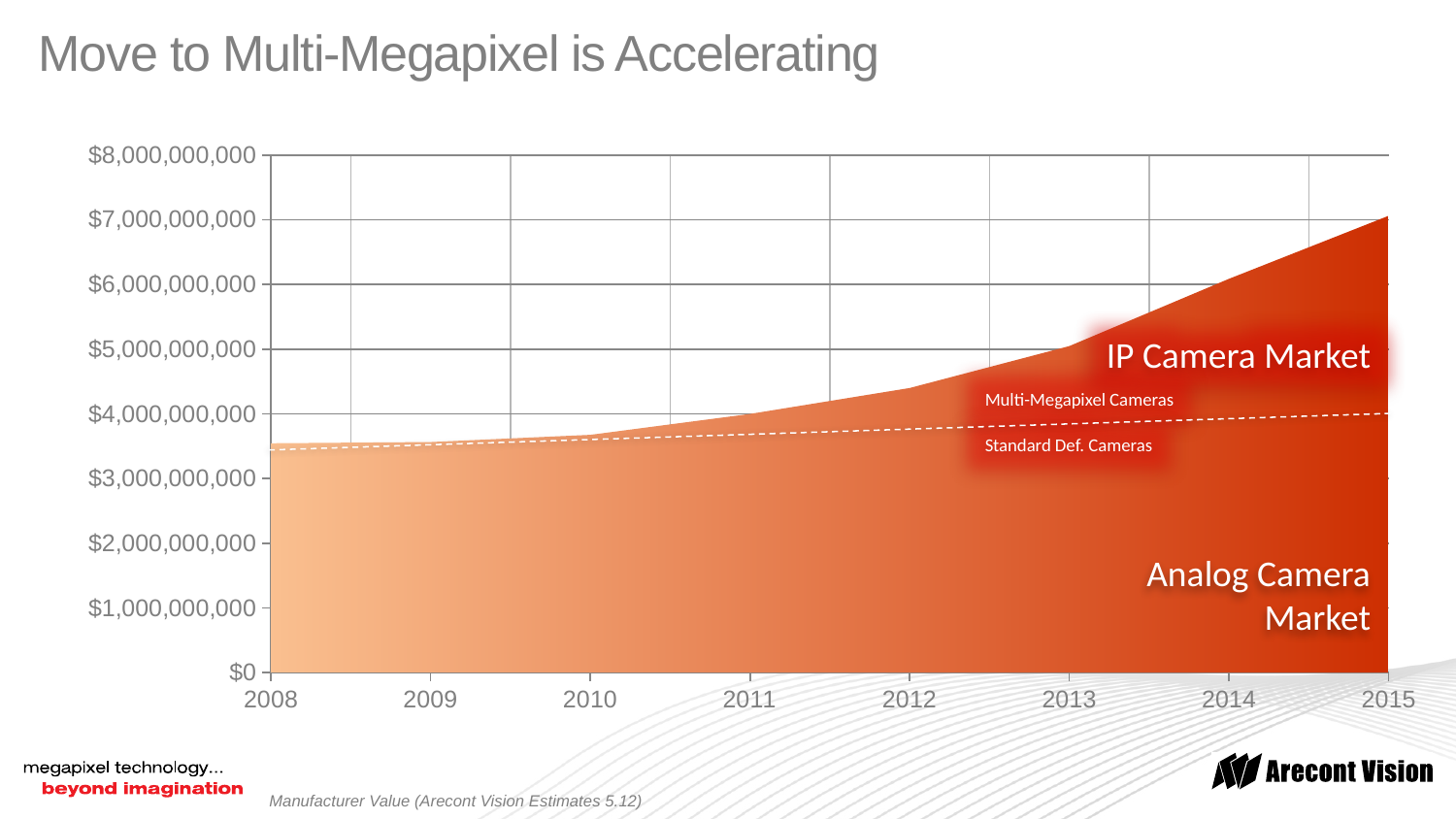
Does the total market value rise or fall from 2008 to 2015? Rise Which is larger, the total market value in 2014 or in 2011? 2014 How many years are shown along the x axis of the chart? 8 What kind of chart is shown on the slide? Area chart Is the total market value in 2010 greater or less than $4,000,000,000? less Is the total market value in 2015 greater or less than $6,000,000,000? greater What is the highest value shown on the y axis of the chart? $8,000,000,000 In which year is the total market value highest? 2015 Is the total market value in 2013 greater or less than $4,000,000,000? greater What is the title of the slide? Move to Multi-Megapixel is Accelerating